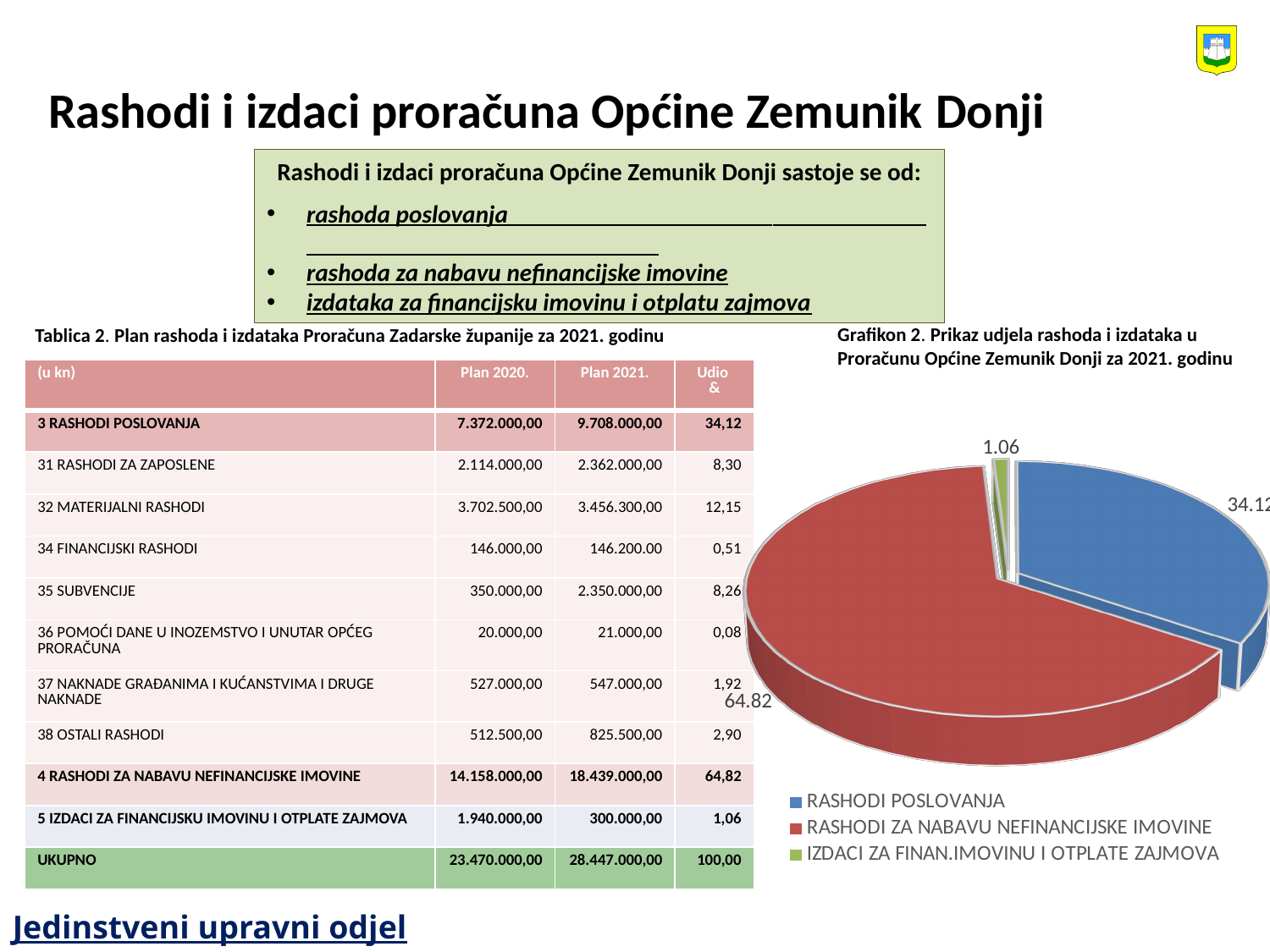
What is the difference between the labelled values for RASHODI ZA NABAVU NEFINANCIJSKE IMOVINE and IZDACI ZA FINAN.IMOVINU I OTPLATE ZAJMOVA in the pie chart? 63.76 What is the title given for the pie chart (Grafikon 2)? Prikaz udjela rashoda i izdataka u Proračunu Općine Zemunik Donji za 2021. godinu How many entries does the legend of the pie chart list? 3 Which category has the largest slice in the pie chart? RASHODI ZA NABAVU NEFINANCIJSKE IMOVINE What colour is the RASHODI POSLOVANJA slice in the pie chart? Blue Which category has the smallest slice in the pie chart? IZDACI ZA FINAN.IMOVINU I OTPLATE ZAJMOVA How many slices does the pie chart have? 3 What share of the pie does the RASHODI ZA NABAVU NEFINANCIJSKE IMOVINE slice represent, according to its label? 64.82 What value is labelled on the pie chart for IZDACI ZA FINAN.IMOVINU I OTPLATE ZAJMOVA? 1.06 What value is labelled on the pie chart for RASHODI ZA NABAVU NEFINANCIJSKE IMOVINE? 64.82 In the pie chart, which is larger: RASHODI POSLOVANJA or IZDACI ZA FINAN.IMOVINU I OTPLATE ZAJMOVA? RASHODI POSLOVANJA What type of chart is shown on the slide? Pie chart